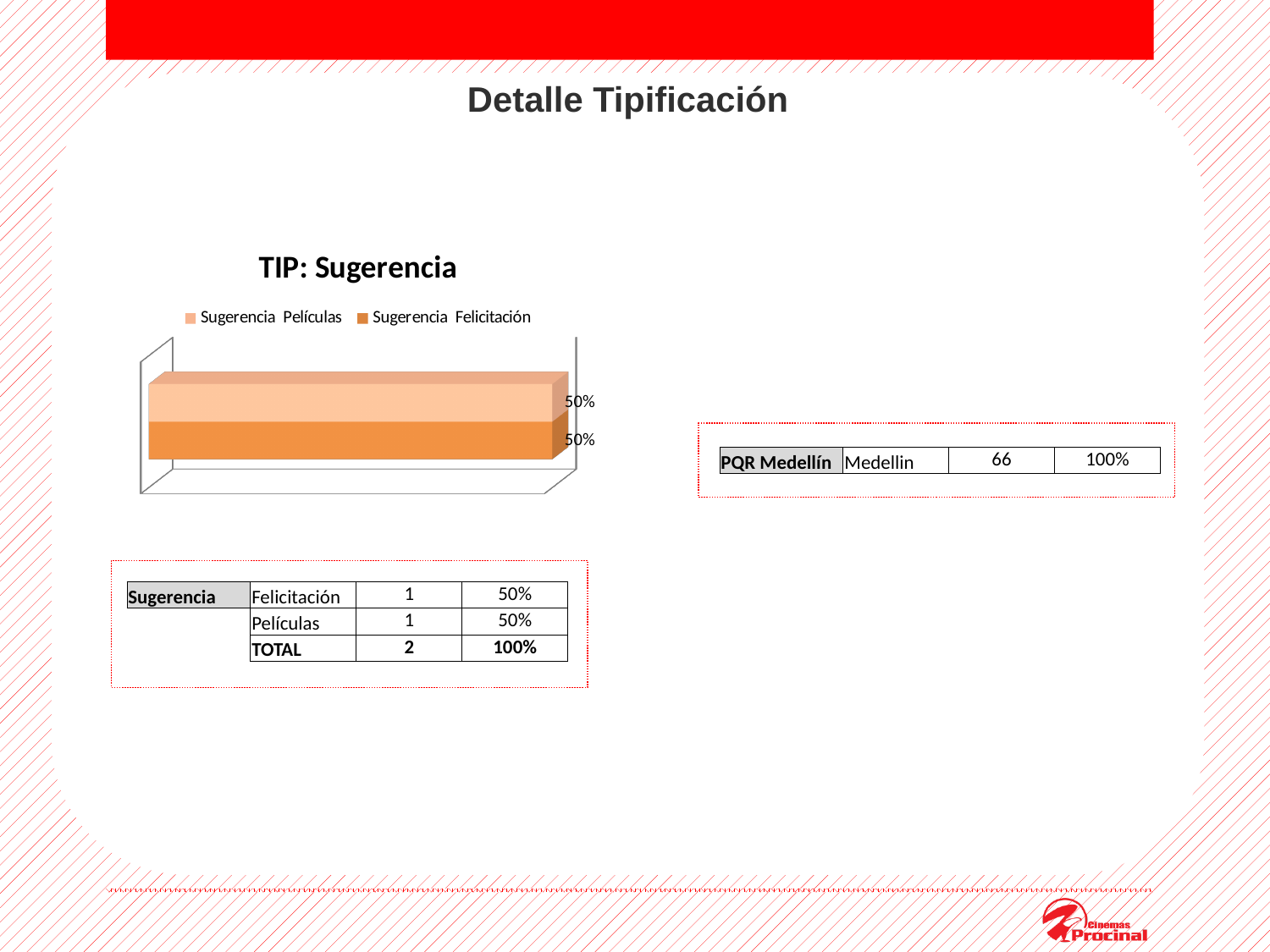
What is the title of the chart? TIP: Sugerencia Do Sugerencia Películas and Sugerencia Felicitación have the same value in the chart? Yes What is the value shown for Sugerencia Felicitación in the chart? 50% How many series does the chart legend list? 2 Is the value for Sugerencia Felicitación greater or less than 100%? less What is the value shown for Sugerencia Películas in the chart? 50% What kind of chart is shown on the slide? Bar chart What is the difference between the values for Sugerencia Películas and Sugerencia Felicitación? 0% How many bars are plotted in the chart? 2 Which legend entry is shown in the lighter orange colour? Sugerencia Películas